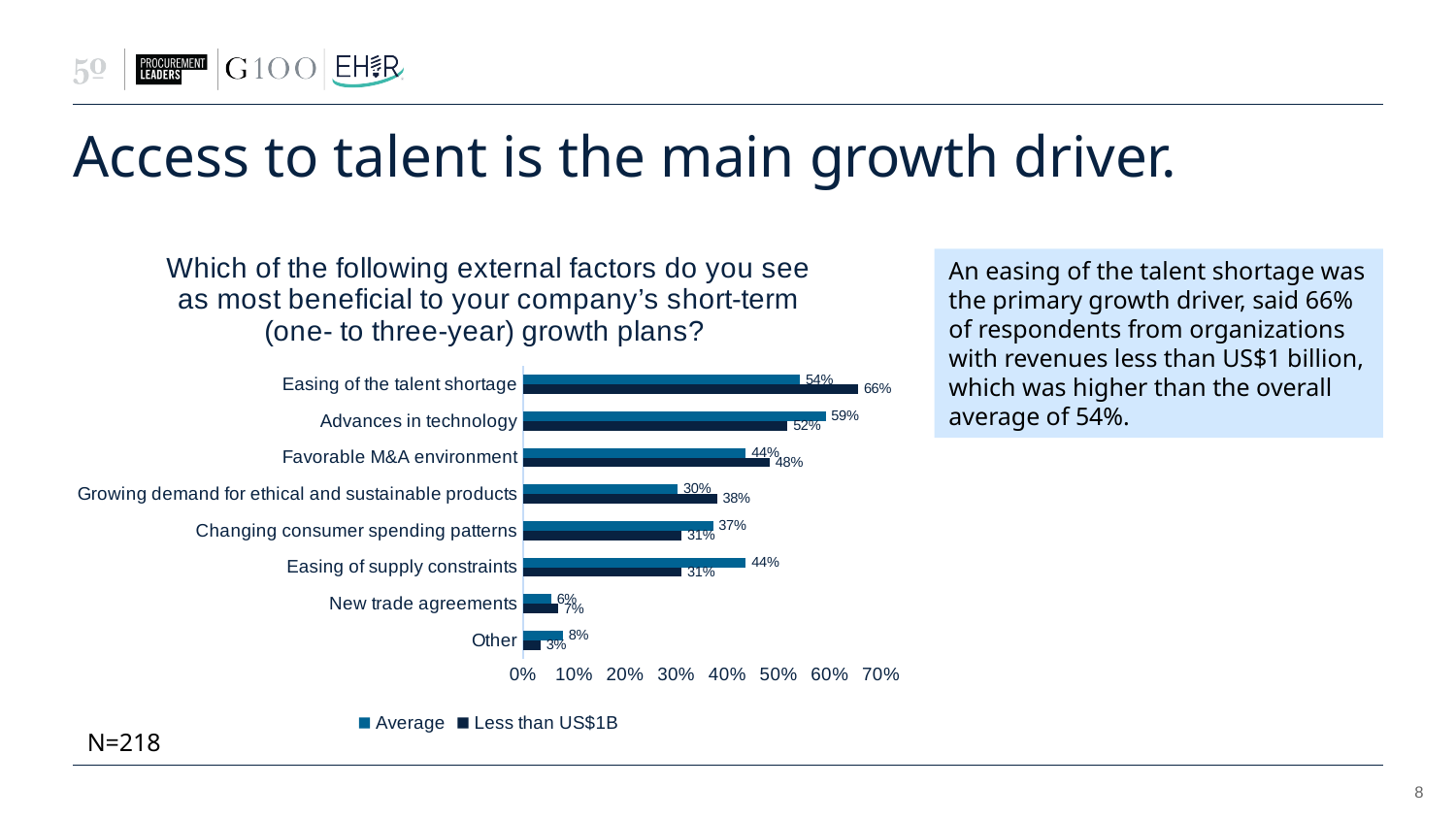
For Easing of supply constraints, which is larger: the Average value or the Less than US$1B value? Average What is the difference between the Less than US$1B and Average values for Easing of the talent shortage? 12% How many series does the legend list? 2 Which category has the highest Less than US$1B value? Easing of the talent shortage What is the Average value for Easing of the talent shortage? 54% What is the Less than US$1B value for Easing of the talent shortage? 66% What kind of chart is shown on the slide? Bar chart What is the Average value for Advances in technology? 59% What are the two series named in the legend? Average and Less than US$1B Which category has the lowest Average value? New trade agreements What is the Less than US$1B value for Growing demand for ethical and sustainable products? 38% How many categories are shown in the chart? 8